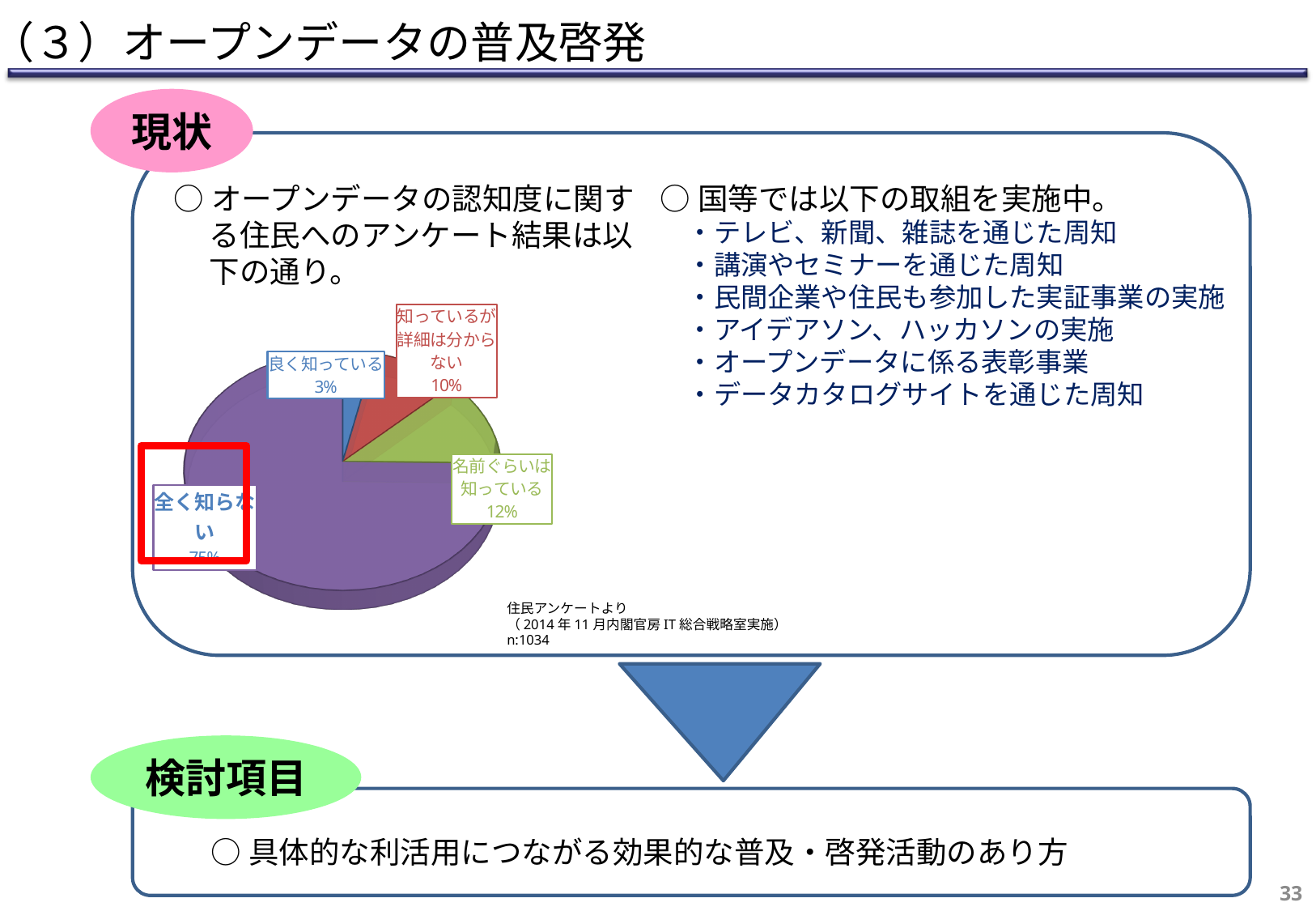
What is the difference in percentage points between 名前ぐらいは知っている and 知っているが詳細は分からない? 2 What kind of chart is shown on the slide? pie chart Which response category has the smallest share of the pie? 良く知っている Which is larger, the share for 名前ぐらいは知っている or the share for 良く知っている? 名前ぐらいは知っている What is the sample size (n) given below the pie chart? 1034 How many slices does the pie chart have? 4 What percentage of respondents answered 良く知っている? 3% Which response category has the largest share of the pie? 全く知らない What percentage of respondents answered 名前ぐらいは知っている? 12% What colour is the 全く知らない slice of the pie chart? purple What percentage of respondents answered 知っているが詳細は分からない? 10% What percentage of respondents answered 全く知らない? 75%